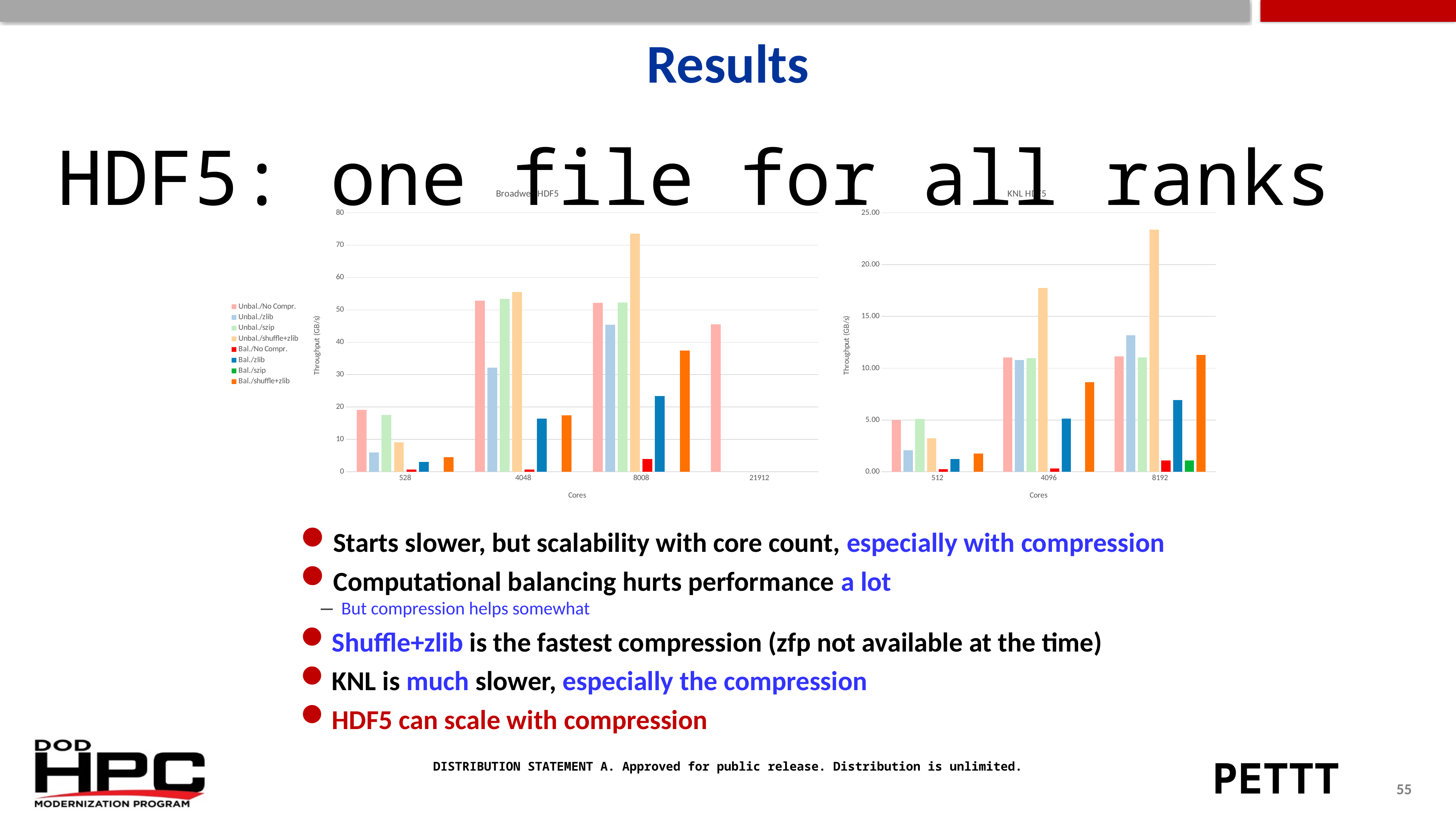
What kind of chart is the left chart on the slide? bar chart How many core-count categories are shown on the x axis of the left chart? 4 In the right (KNL) chart, is the value for Unbal./shuffle+zlib at 8192 cores greater or less than 20.00? greater How many series does the legend on the slide list? 8 In the left chart, which series has the tallest bar at 8008 cores? Unbal./shuffle+zlib What is the label on the y axis of the charts? Throughput (GB/s) In the left chart at 4048 cores, which is larger: Unbal./No Compr. or Unbal./zlib? Unbal./No Compr. In the left chart, is the value for Unbal./shuffle+zlib at 8008 cores greater or less than 70? greater In the right (KNL) chart, which series has the tallest bar at 8192 cores? Unbal./shuffle+zlib In the right (KNL) chart, does the value for Unbal./shuffle+zlib rise or fall as the core count increases from 512 to 8192? rise How many core-count categories are shown on the x axis of the right (KNL) chart? 3